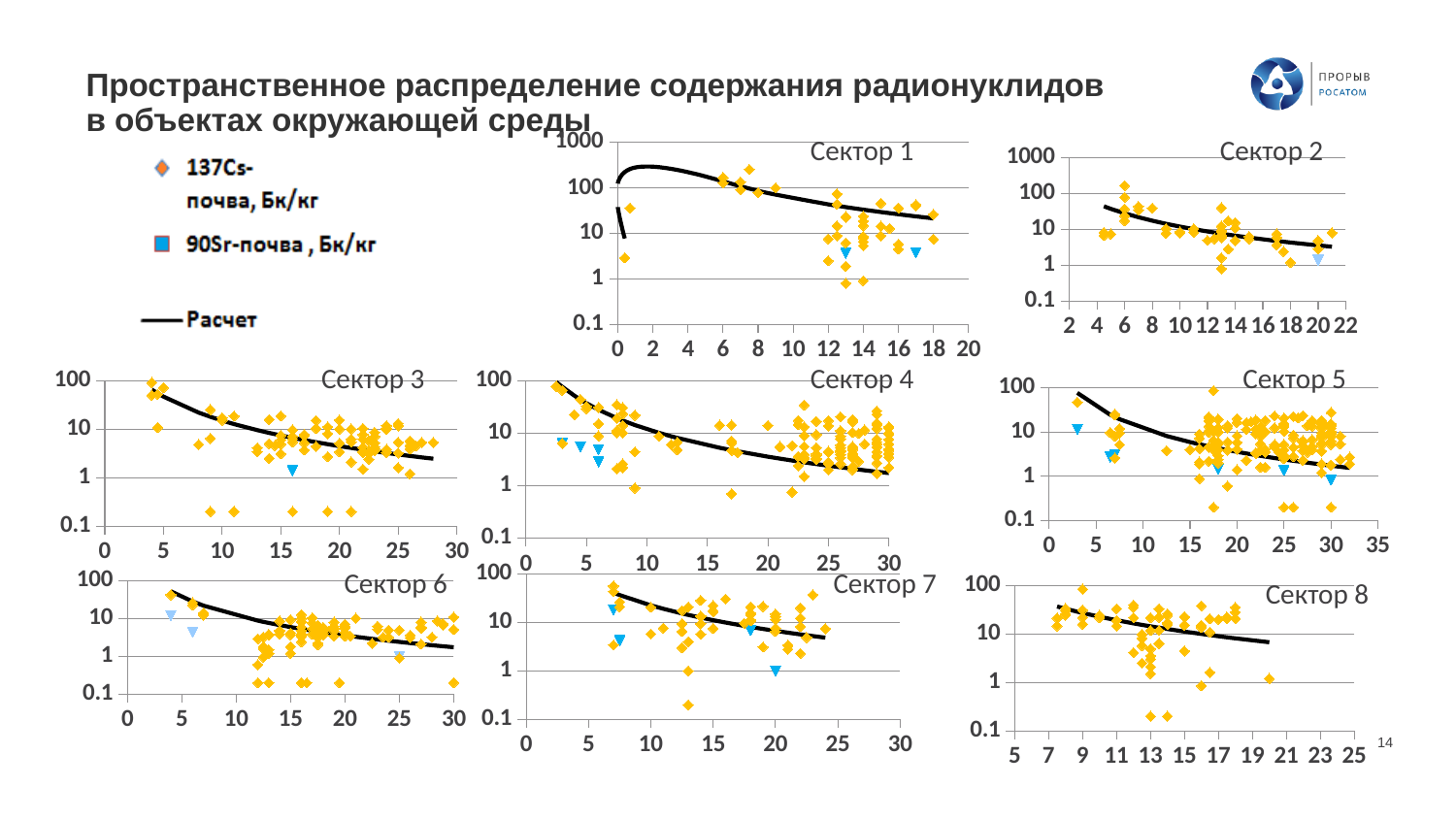
What are the three entries in the legend on the slide? 137Cs-почва, Бк/кг; 90Sr-почва, Бк/кг; Расчет In the Сектор 6 chart, is the value of the Расчет line at x = 30 greater or less than 10? less In the Сектор 3 chart, is the value of the Расчет line at x = 5 greater or less than 10? greater How many series does the legend on the slide list? 3 In the Сектор 5 chart, does the Расчет line rise or fall along the x axis? fall What kind of chart is the Сектор 1 chart? scatter chart How many charts are shown on the slide? 8 In the Сектор 1 chart, what is the highest tick value shown on the y axis? 1000 In the Сектор 2 chart, is the value of the Расчет line at x = 20 greater or less than 10? less In the Сектор 3 chart, does the Расчет line rise or fall as x increases? fall